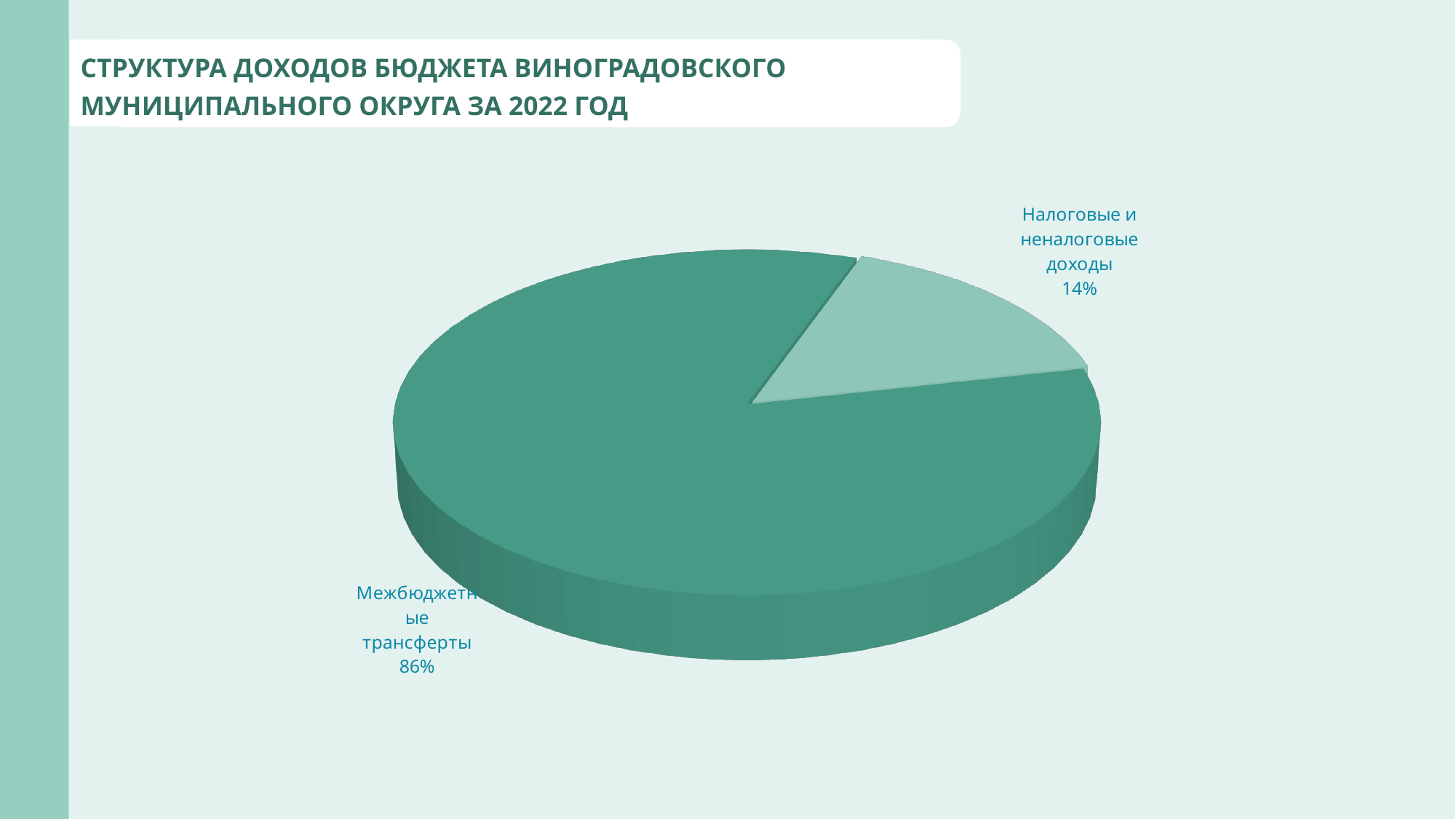
Which category has the smallest share of the pie? Налоговые и неналоговые доходы What is the title of the slide? СТРУКТУРА ДОХОДОВ БЮДЖЕТА ВИНОГРАДОВСКОГО МУНИЦИПАЛЬНОГО ОКРУГА ЗА 2022 ГОД Which year does the chart's data refer to, according to the title? 2022 How many slices does the pie chart have? 2 What kind of chart is shown on the slide? Pie chart What share of the pie does "Межбюджетные трансферты" account for? 86% Which is larger: the share of "Налоговые и неналоговые доходы" or the share of "Межбюджетные трансферты"? Межбюджетные трансферты What is the total of the two percentage shares shown on the pie chart? 100% What share of the pie does "Налоговые и неналоговые доходы" account for? 14% What is the difference in percentage points between the share of "Межбюджетные трансферты" and "Налоговые и неналоговые доходы"? 72 percentage points Which category has the largest share of the pie? Межбюджетные трансферты